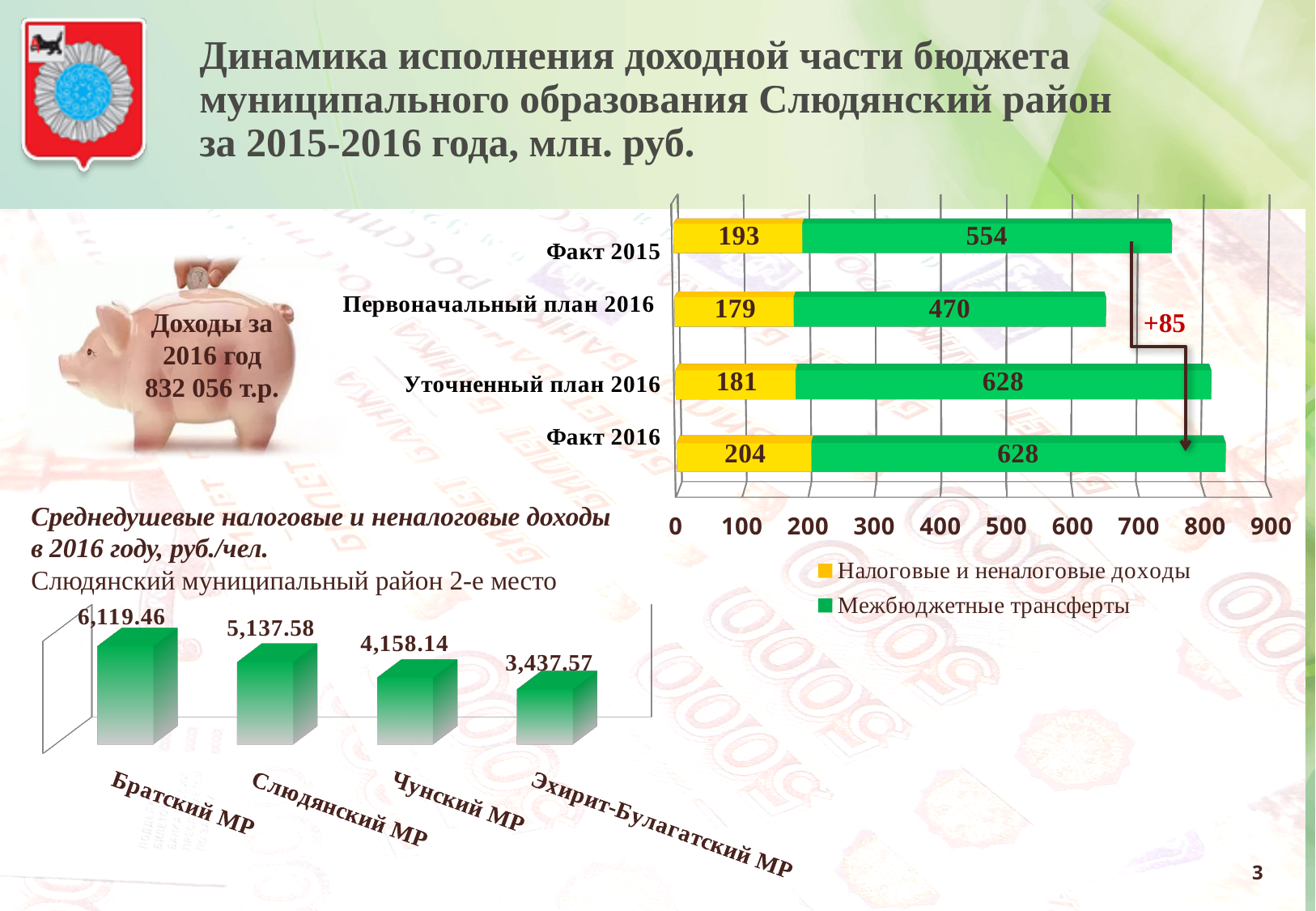
In the stacked bar chart on the right, how many series does the legend list? 2 In the stacked bar chart on the right, how many categories are shown? 4 In the stacked bar chart on the right, what is the value of Налоговые и неналоговые доходы for Факт 2016? 204 In the stacked bar chart on the right, what is the difference between Межбюджетные трансферты for Уточненный план 2016 and for Первоначальный план 2016? 158 In the stacked bar chart on the right, which colour represents Межбюджетные трансферты? Green In the stacked bar chart on the right, what is the total of the Факт 2015 bar? 747 In the chart titled 'Среднедушевые налоговые и неналоговые доходы в 2016 году, руб./чел.', what is the value for Слюдянский МР? 5,137.58 In the stacked bar chart on the right, which category has the lowest value of Налоговые и неналоговые доходы? Первоначальный план 2016 In the chart titled 'Среднедушевые налоговые и неналоговые доходы в 2016 году, руб./чел.', do the values rise or fall from left to right? Fall In the chart titled 'Среднедушевые налоговые и неналоговые доходы в 2016 году, руб./чел.', which category has the highest value? Братский МР In the stacked bar chart on the right, what is the value of Межбюджетные трансферты for Первоначальный план 2016? 470 What kind of chart is the one at the bottom left of the slide? Bar chart